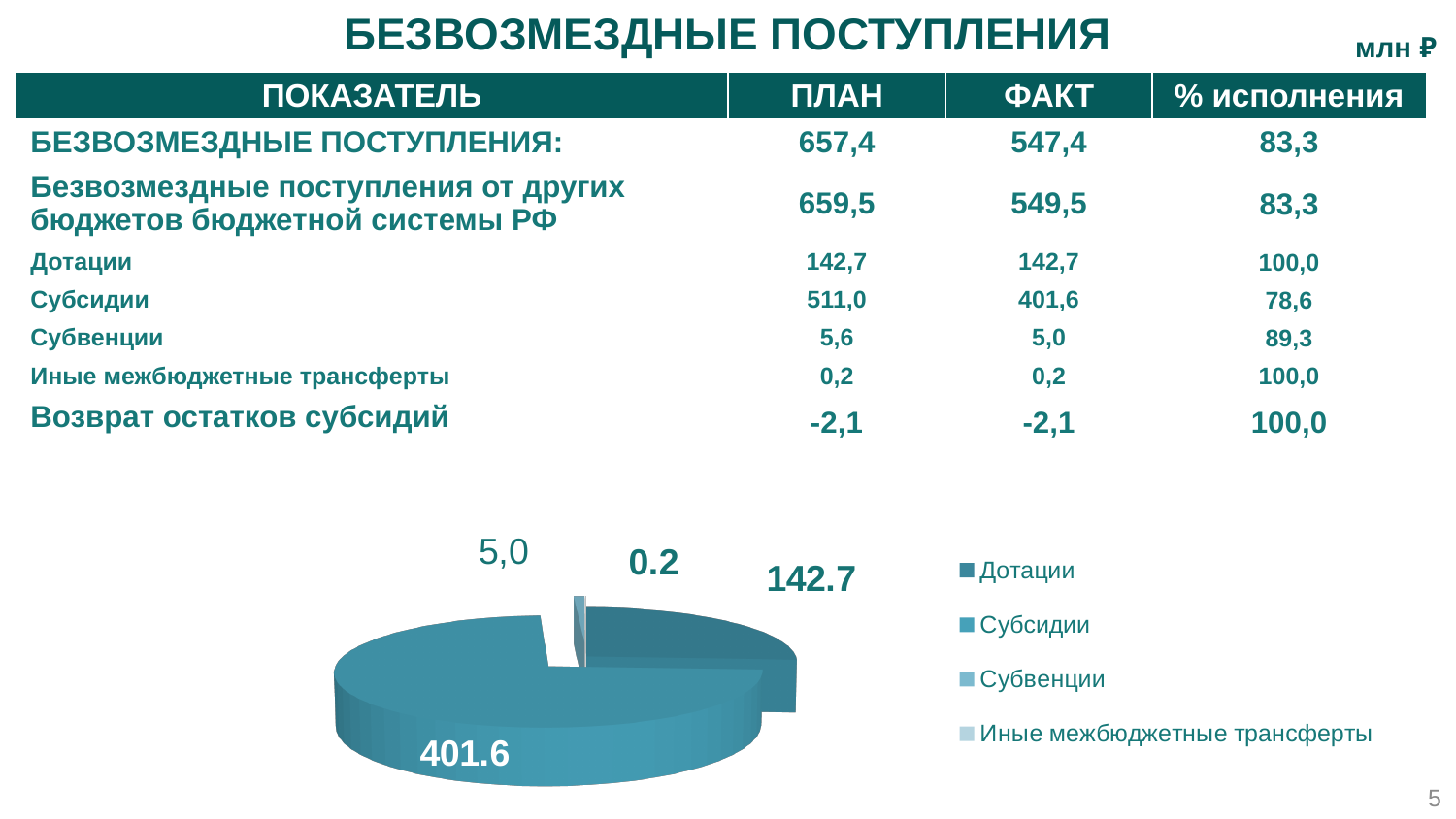
Which category has the smallest slice in the pie chart? Иные межбюджетные трансферты In the pie chart, what is the value for Дотации? 142.7 In the pie chart, what is the value for Субсидии? 401.6 What is the total of all the values shown in the pie chart? 549.5 What kind of chart is shown on the slide? Pie chart How many slices does the pie chart have? 4 What is the difference between the values for Субсидии and Дотации in the pie chart? 258.9 In the pie chart, which is larger: Дотации or Субвенции? Дотации Which category has the largest slice in the pie chart? Субсидии How many entries does the pie chart's legend list? 4 In the pie chart, what is the value for Иные межбюджетные трансферты? 0.2 In the pie chart, what is the value for Субвенции? 5,0